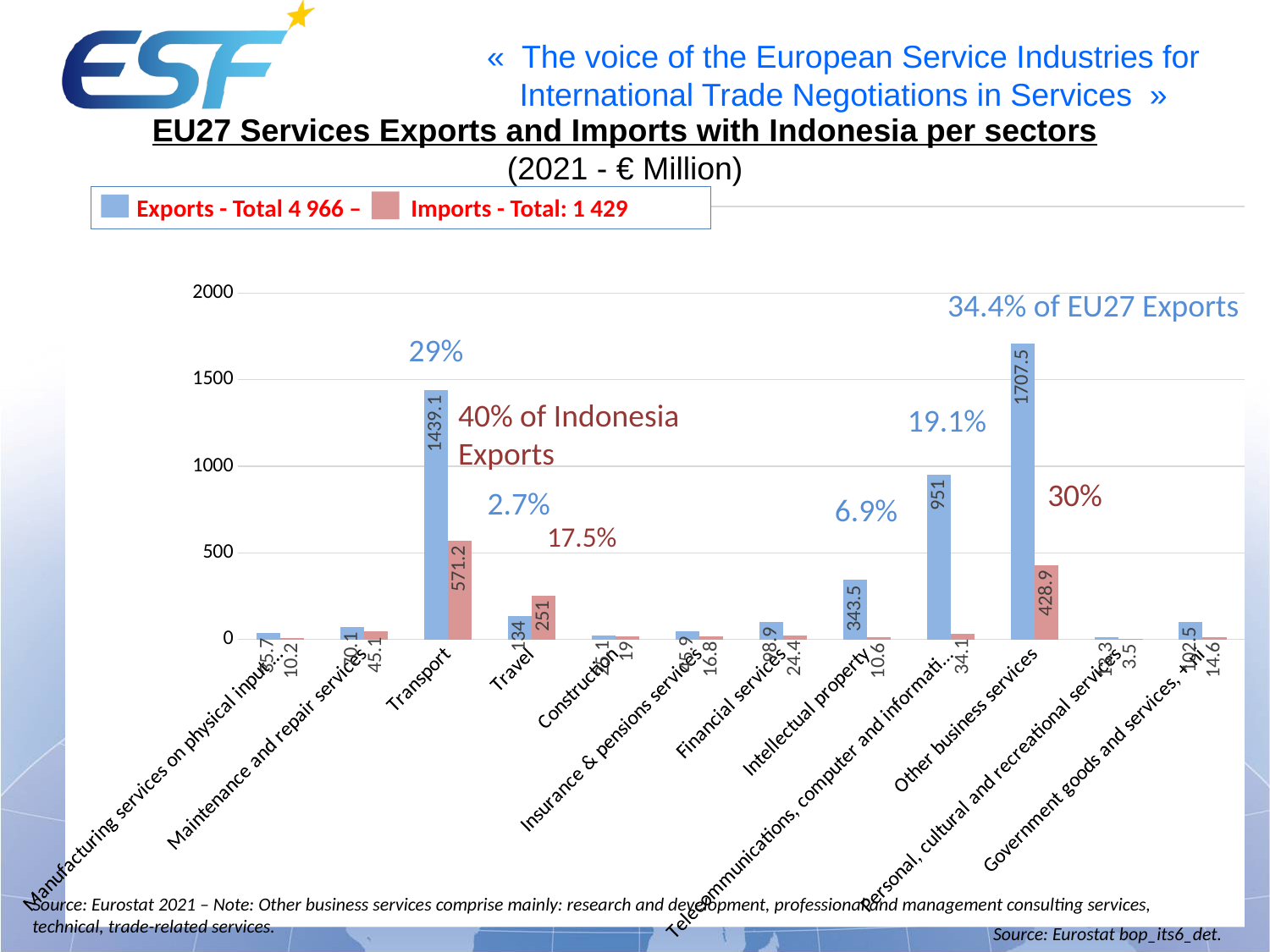
How many sector categories are plotted on the x axis? 12 What is the Imports value for Other business services? 428.9 For Travel, which is larger: Exports or Imports? Imports Which sector has the highest value for Exports? Other business services What kind of chart is shown on the slide? bar chart How many series does the legend list? 2 What is the Exports value for Transport? 1439.1 According to the legend, what is the total of Exports? 4 966 What is the difference between the Exports values for Other business services and Transport? 268.4 Is the Imports value for Transport greater or less than 500? greater What is the Exports value for Telecommunications, computer and information services? 951 Which sector has the highest value for Imports? Transport